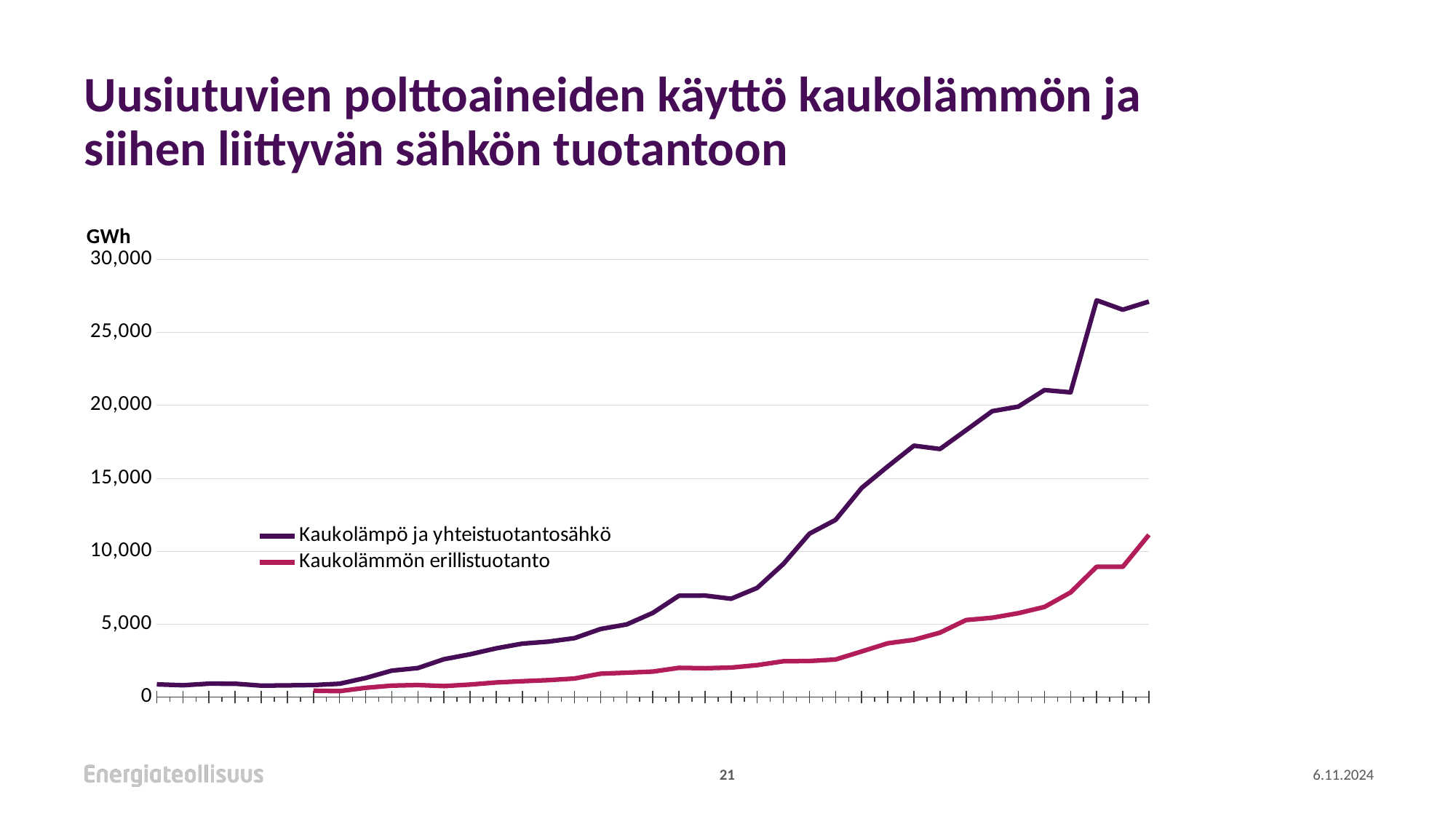
Is the final value of the Kaukolämpö ja yhteistuotantosähkö series greater or less than 25,000? greater Does the Kaukolämpö ja yhteistuotantosähkö series generally rise or fall along the x axis? rise Which series is shown in the dark purple line? Kaukolämpö ja yhteistuotantosähkö What is the highest value labelled on the vertical axis? 30,000 Is the highest value reached by the Kaukolämpö ja yhteistuotantosähkö series greater or less than 30,000? less Does the Kaukolämmön erillistuotanto series generally rise or fall along the x axis? rise Is the final value of the Kaukolämmön erillistuotanto series greater or less than 10,000? greater How many series does the legend list? 2 What unit is shown on the vertical axis of the chart? GWh At the right end of the chart, which series has the higher value: Kaukolämpö ja yhteistuotantosähkö or Kaukolämmön erillistuotanto? Kaukolämpö ja yhteistuotantosähkö What kind of chart is shown on the slide? line chart